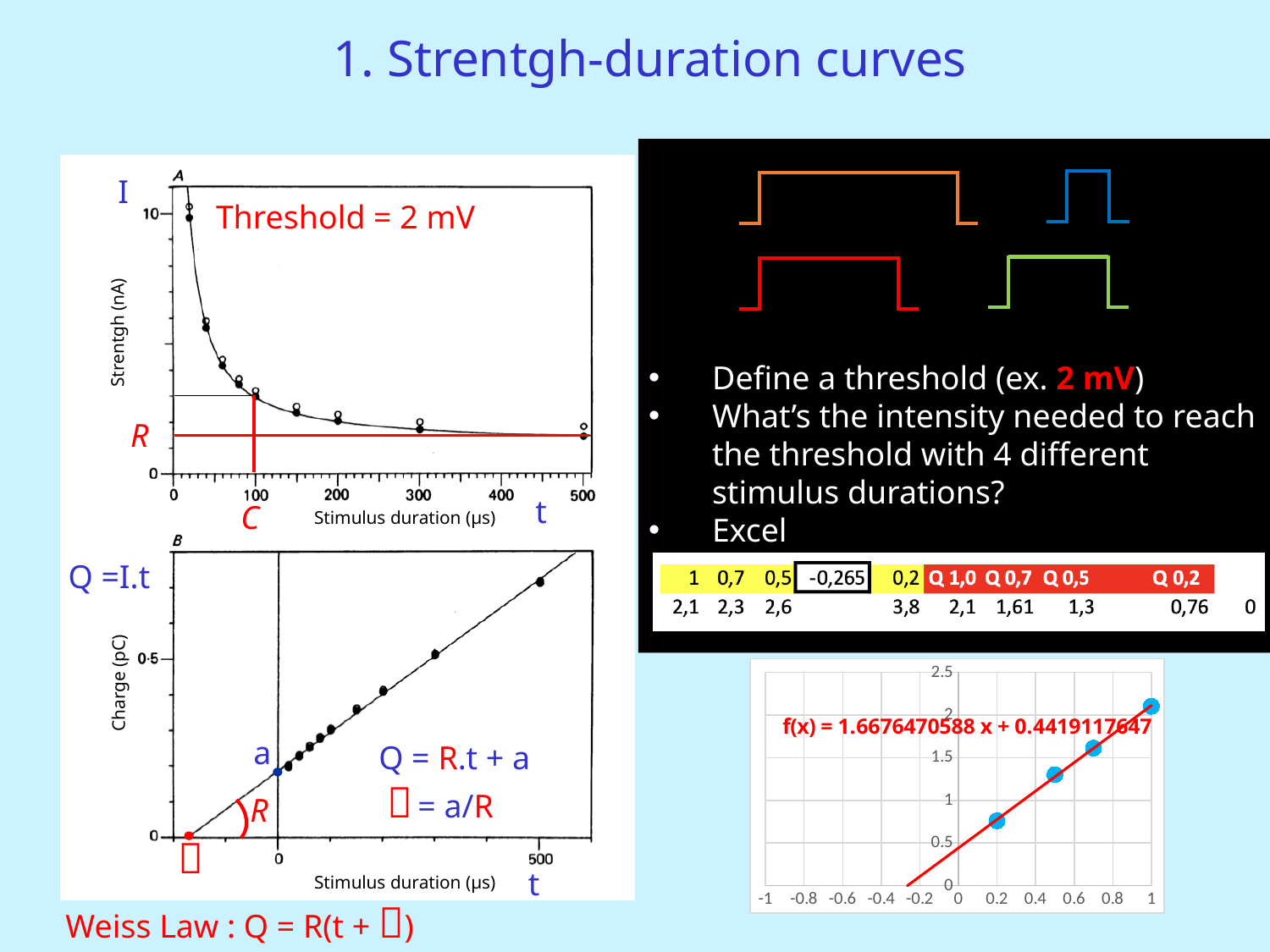
What is the y-axis label of chart B at the bottom left? Charge (pC) On the Excel scatter chart at the bottom right, what is the highest value shown on the vertical axis? 2.5 On the Excel scatter chart at the bottom right, which plotted point has the highest value, the one at x = 0.2 or the one at x = 1? x = 1 What kind of chart is the Excel chart at the bottom right of the slide? scatter chart On the Excel scatter chart at the bottom right, what is the equation of the fitted line shown? f(x) = 1.6676470588 x + 0.4419117647 In chart A at the top left, does the strength value rise or fall as stimulus duration increases? fall On the Excel scatter chart at the bottom right, is the value of the point at x = 0.7 greater or less than 2? less On the Excel scatter chart at the bottom right, do the plotted values rise or fall as x increases? rise In chart B at the bottom left, does the charge rise or fall as stimulus duration increases? rise On the Excel scatter chart at the bottom right, is the value of the point at x = 0.2 greater or less than 1? less How many data points are plotted on the Excel scatter chart at the bottom right? 4 On the Excel scatter chart at the bottom right, is the value of the point at x = 0.5 greater or less than 1? greater